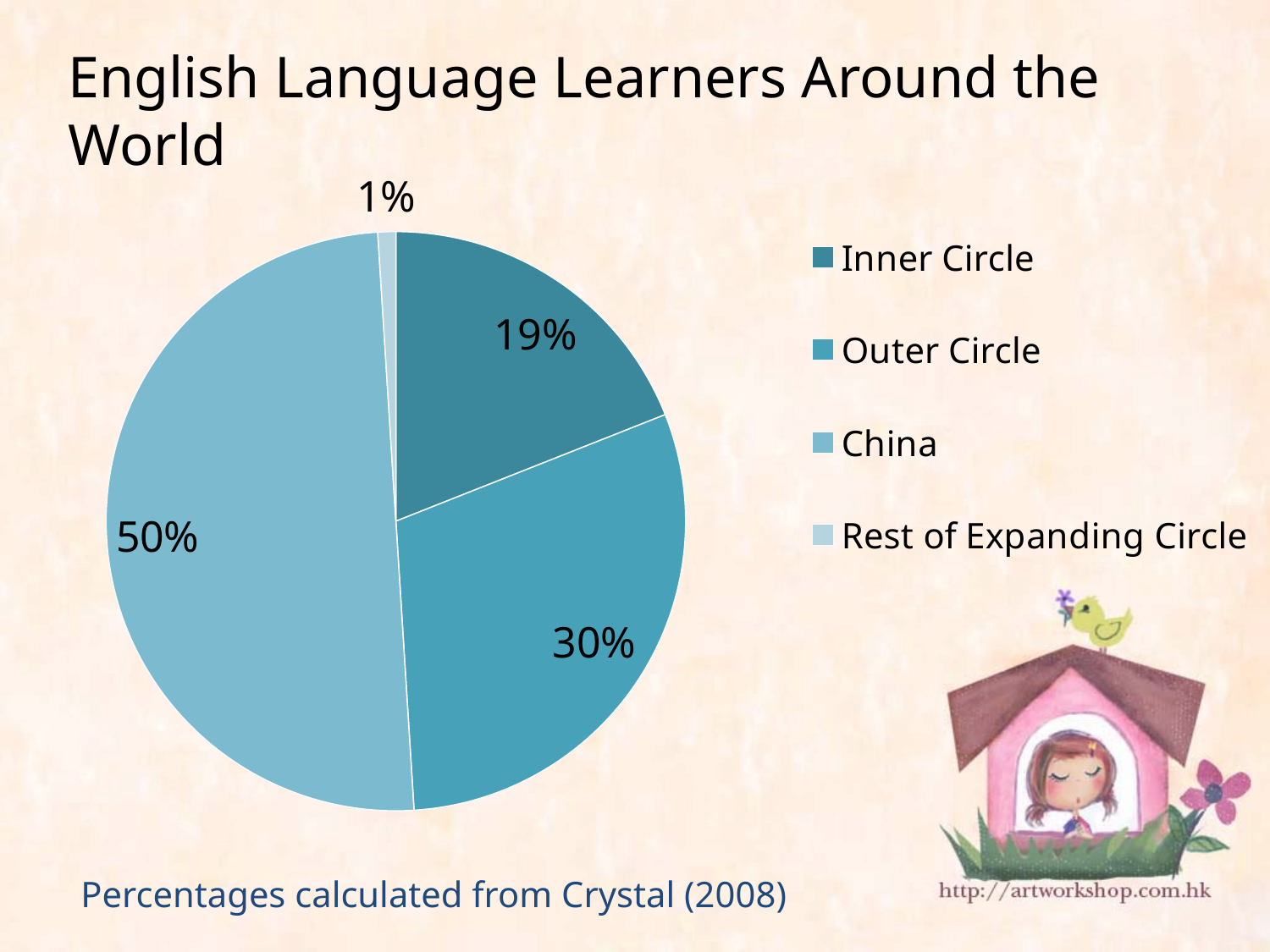
What is the difference in percentage points between the Outer Circle slice and the Inner Circle slice? 11 What is the title of the slide containing the pie chart? English Language Learners Around the World What percentage is shown for the Rest of Expanding Circle slice? 1% What percentage of the pie is labelled for the Inner Circle slice? 19% What percentage is shown for the China slice? 50% How many entries does the legend list? 4 Which is larger, the Inner Circle slice or the Outer Circle slice? Outer Circle What percentage is shown for the Outer Circle slice? 30% How many slices does the pie chart have? 4 What kind of chart is shown on the slide? pie chart Which slice of the pie is the largest? China Which slice of the pie is the smallest? Rest of Expanding Circle